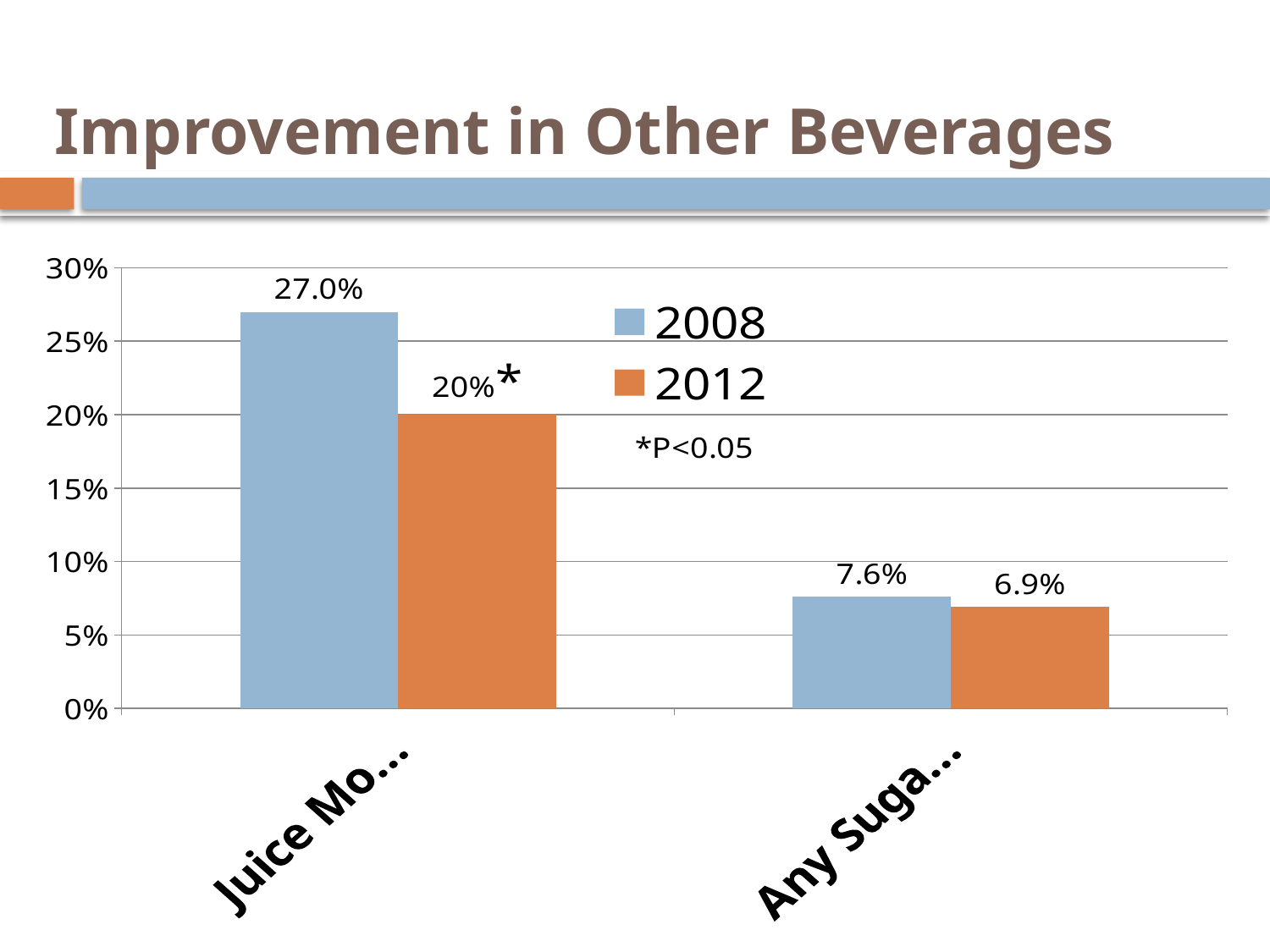
What is the 2008 value for the left category (Juice Mo...)? 27.0% Which bar has the highest value on the chart? 2008 for the left category (Juice Mo...), 27.0% What does the asterisk next to the 20% label indicate, according to the note on the chart? P<0.05 What is the difference between the 2008 and 2012 values for the left category (Juice Mo...)? 7.0 percentage points What is the 2008 value for the right category (Any Suga...)? 7.6% What is the 2012 value for the left category (Juice Mo...)? 20% Is the 2012 value for the left category (Juice Mo...) greater or less than 25%? less What kind of chart is shown on the slide? bar chart What is the 2012 value for the right category (Any Suga...)? 6.9% Is the 2008 value for the right category (Any Suga...) larger or smaller than the 2012 value for that category? larger Which bar has the lowest value on the chart? 2012 for the right category (Any Suga...), 6.9% How many series does the legend list? 2